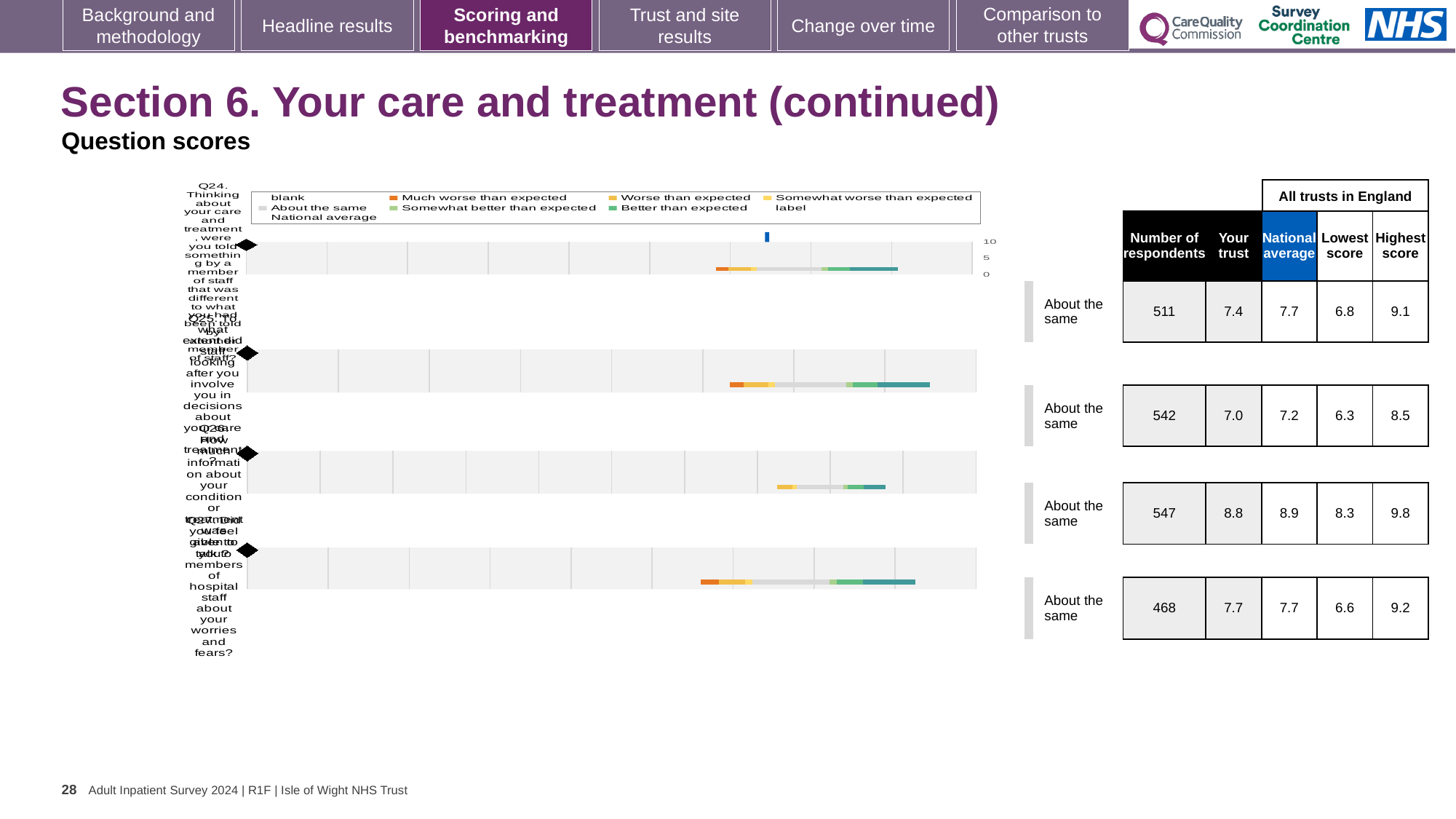
What is the lowest score among all trusts in England for Q26? 8.3 What benchmark category is shown for Q27? About the same Which is larger for Q25: the trust score or the national average? National average Which question has the highest 'Your trust' score? Q26 How many respondents answered Q26 (the third row)? 547 What is the 'Your trust' score for Q24 (the first row)? 7.4 How many questions (rows) are plotted in the chart? 4 What is the difference between the national average and the trust score for Q24? 0.3 What kind of chart is used to show the question scores? bar chart What is the highest score among all trusts in England for Q27 (the fourth row)? 9.2 Which question has the lowest 'Your trust' score? Q25 What is the national average for Q25 (the second row)? 7.2